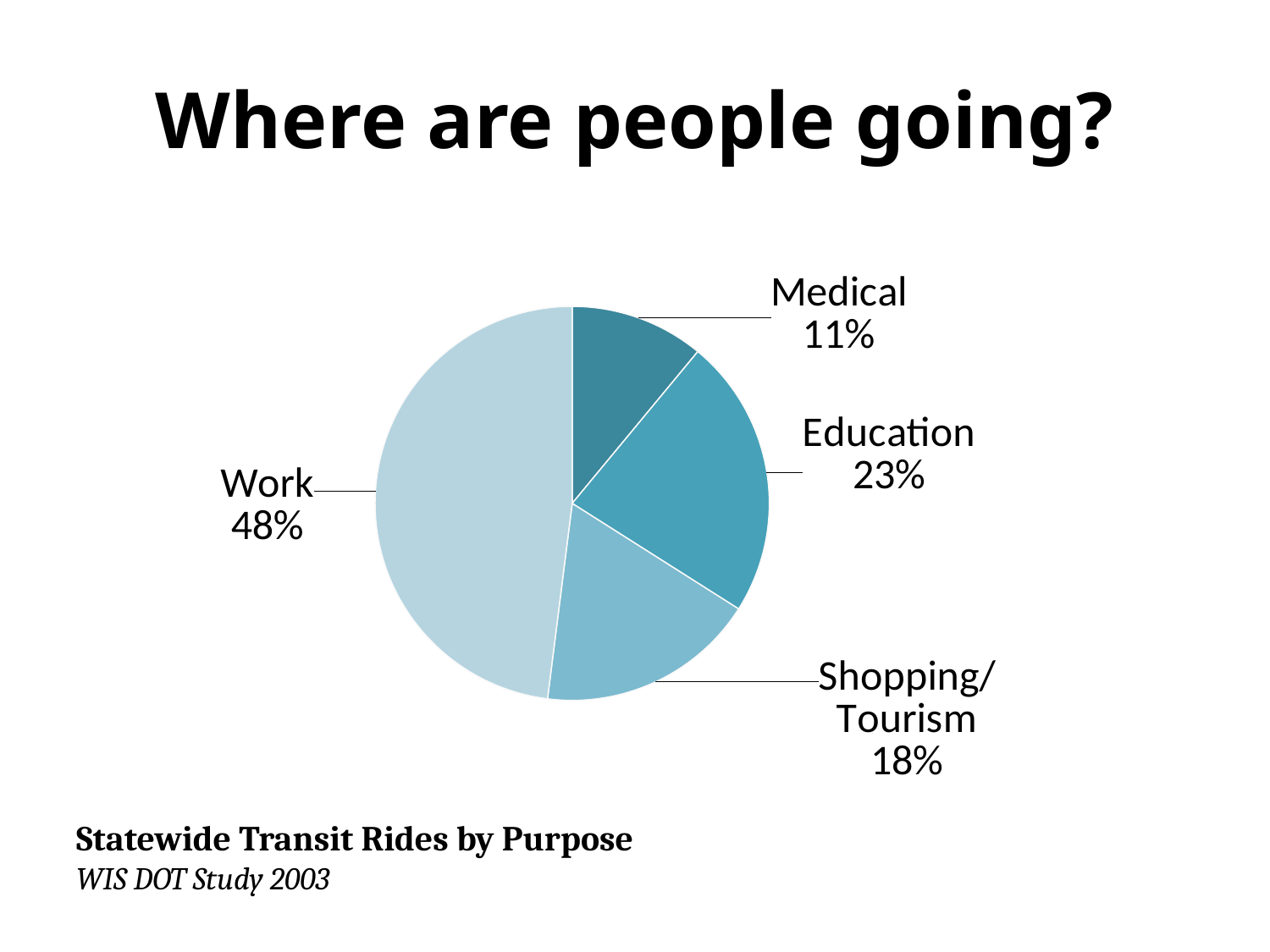
Which is larger, the share for Education or the share for Shopping/Tourism? Education What share of statewide transit rides is for Education? 23% What kind of chart is shown on the slide? Pie chart How many purpose categories are shown in the pie chart? 4 What share of statewide transit rides is for Work? 48% What is the caption below the chart that names the data shown? Statewide Transit Rides by Purpose What share of statewide transit rides is for Shopping/Tourism? 18% What share of statewide transit rides is for Medical purposes? 11% Which purpose accounts for the smallest share of transit rides? Medical Which purpose accounts for the largest share of transit rides? Work What is the difference in percentage points between Shopping/Tourism and Medical? 7 How many percentage points larger is the Work share than the Education share? 25